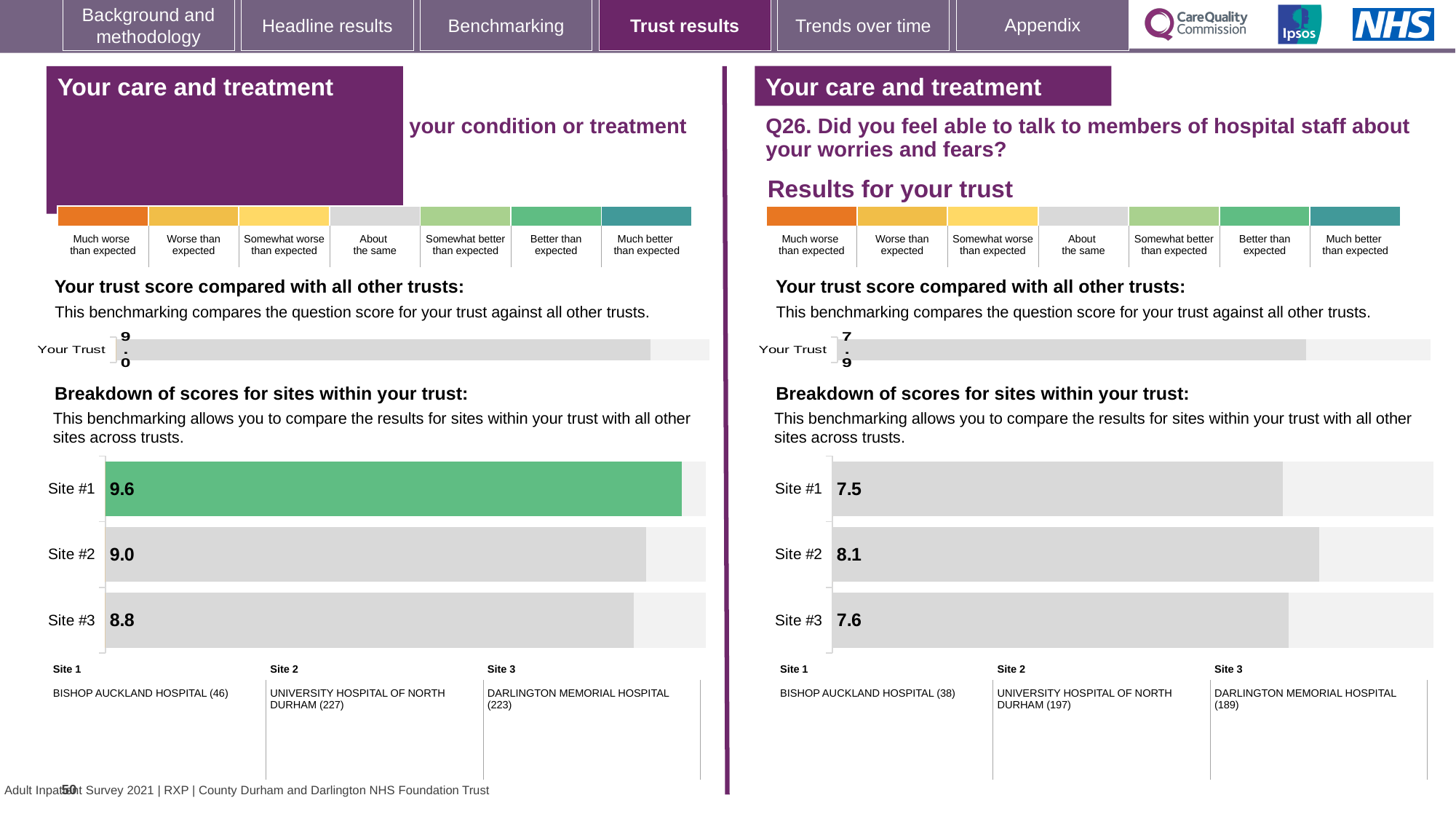
How many sites are shown on the right-hand (Q26) site breakdown chart? 3 On the right-hand (Q26) site breakdown chart, what is the score for Site #2? 8.1 On the left-hand site breakdown chart, which site has the highest score? Site #1 On the right-hand (Q26) site breakdown chart, which site has the lowest score? Site #1 On the left-hand 'Your trust score compared with all other trusts' chart, what is the score shown for Your Trust? 9.0 On the left-hand site breakdown chart, what is the difference between the scores for Site #1 and Site #3? 0.8 On the right-hand (Q26) 'Your trust score compared with all other trusts' chart, what is the score shown for Your Trust? 7.9 On the right-hand (Q26) site breakdown chart, what is the score for Site #1? 7.5 On the right-hand (Q26) site breakdown chart, what is the difference between the scores for Site #2 and Site #1? 0.6 On the left-hand site breakdown chart, what is the score for Site #3? 8.8 On the right-hand (Q26) site breakdown chart, which site has the highest score? Site #2 On the left-hand 'Breakdown of scores for sites within your trust' chart, what is the score for Site #1? 9.6